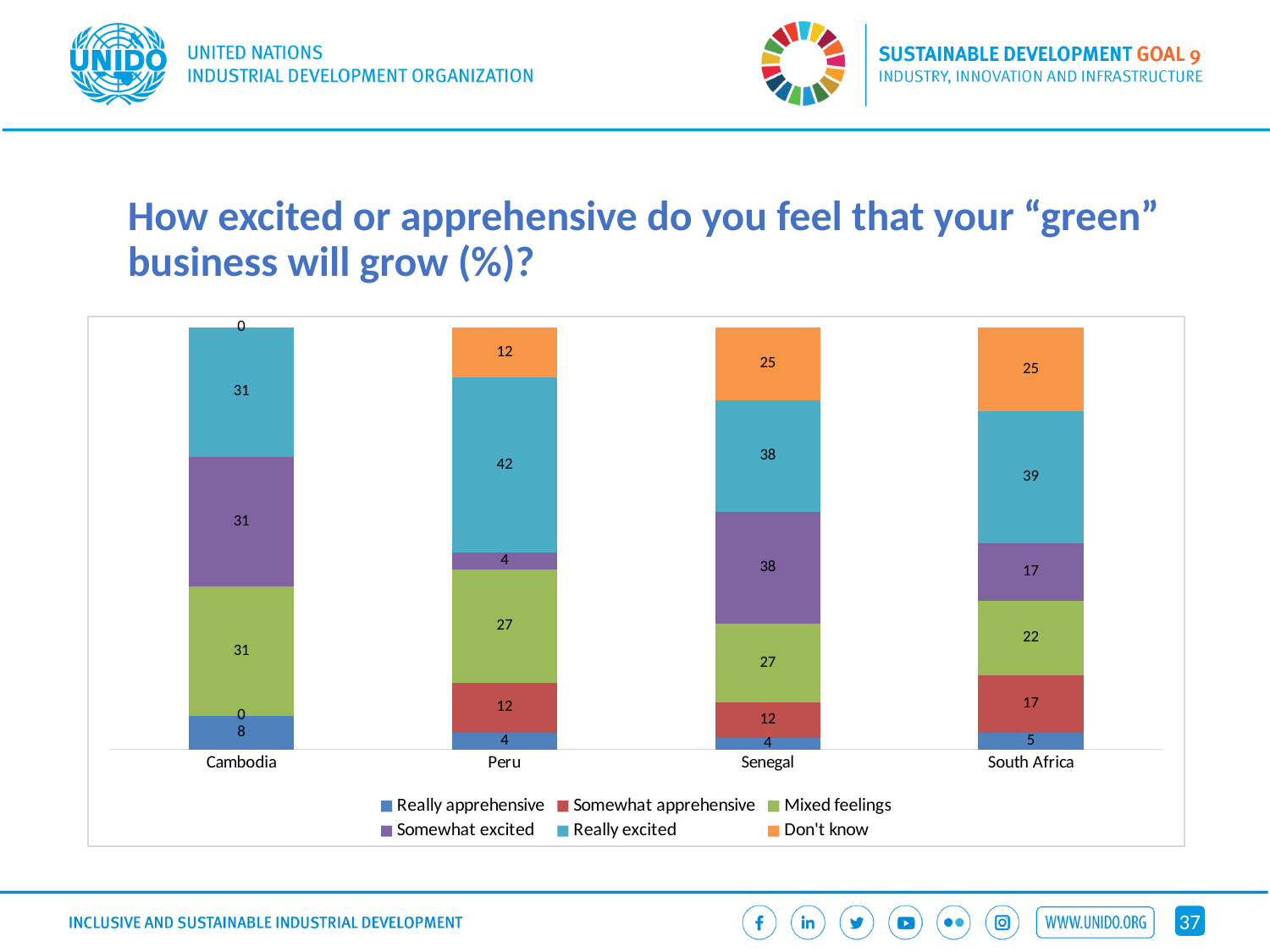
How many series does the chart's legend list? 6 What kind of chart is shown on the slide? Stacked bar chart What colour represents 'Don't know' in the chart's legend? Orange What is the 'Somewhat apprehensive' value for South Africa? 17 How many countries are shown on the x axis of the chart? 4 Which country has the lowest 'Don't know' value? Cambodia Which country has the larger 'Mixed feelings' value, Cambodia or South Africa? Cambodia Which country has the highest 'Really excited' value? Peru What is the difference between the 'Somewhat excited' values for Senegal and Peru? 34 What is the 'Really excited' value for Peru? 42 What is the 'Don't know' value for Senegal? 25 What is the 'Really apprehensive' value for Cambodia? 8